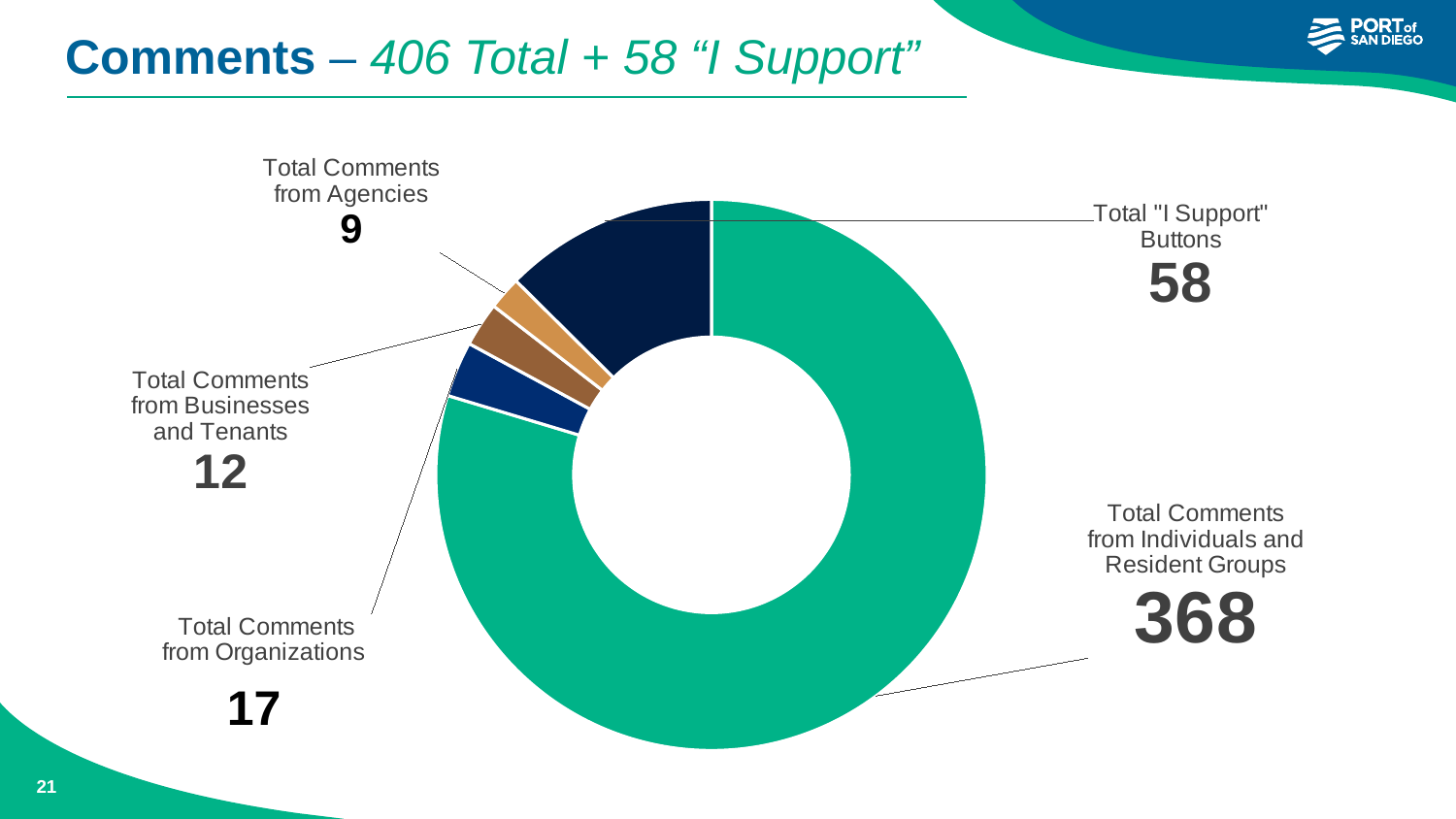
Which category has the smallest slice of the chart? Total Comments from Agencies How many Total Comments from Agencies are shown? 9 How many Total Comments from Individuals and Resident Groups are shown on the chart? 368 What is the difference between Total Comments from Individuals and Resident Groups and Total "I Support" Buttons? 310 What is the value for Total "I Support" Buttons? 58 What is the value for Total Comments from Businesses and Tenants? 12 What is the difference between Total Comments from Organizations and Total Comments from Agencies? 8 Which is larger: Total Comments from Businesses and Tenants or Total Comments from Organizations? Total Comments from Organizations How many Total Comments from Organizations are shown? 17 What kind of chart is shown on the slide? Doughnut chart Which category has the largest slice of the chart? Total Comments from Individuals and Resident Groups How many categories (slices) does the chart show? 5